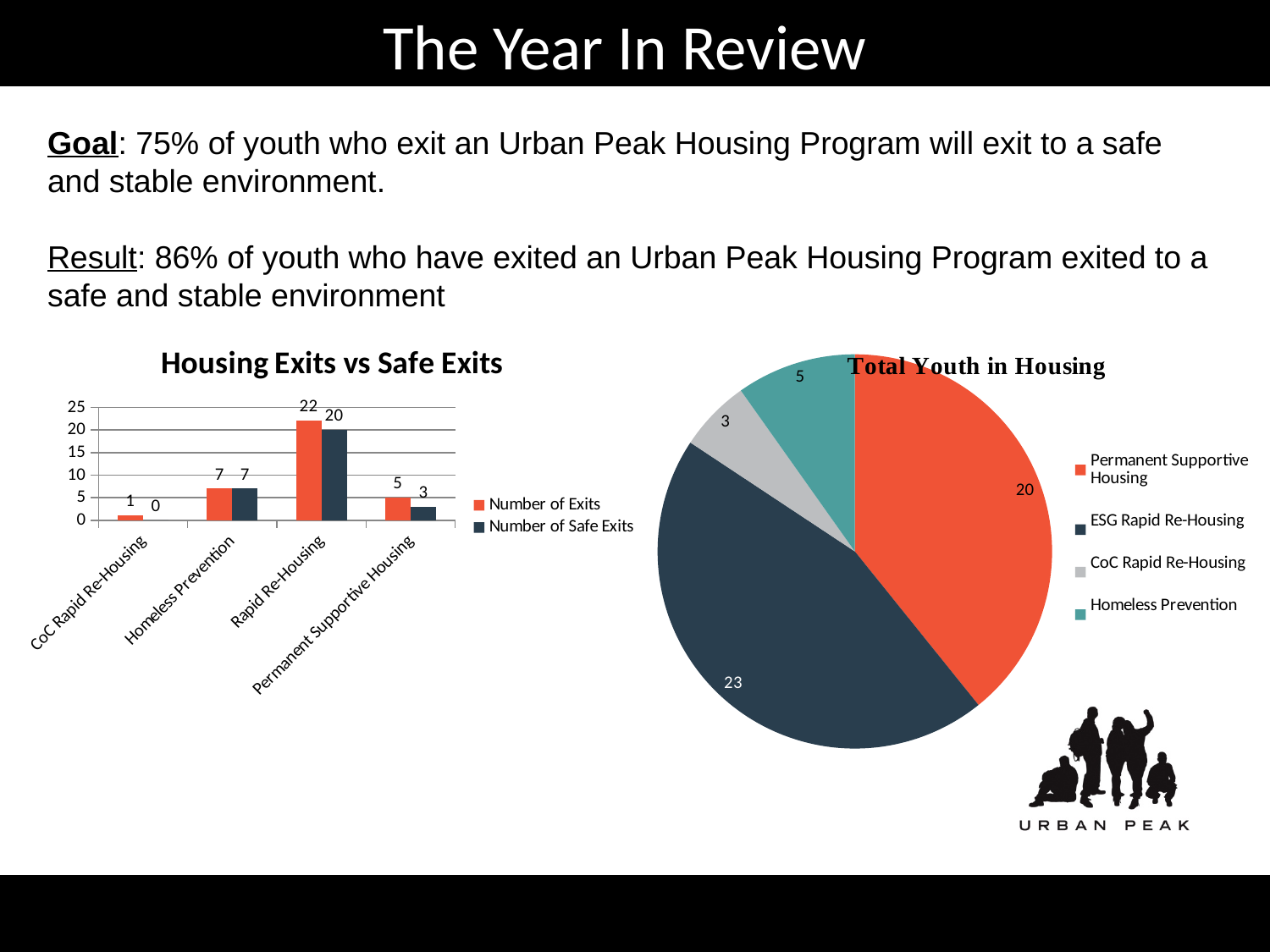
In the 'Total Youth in Housing' pie chart, which program has the smallest slice? CoC Rapid Re-Housing In the 'Total Youth in Housing' pie chart, what is the total of all slices? 51 In the 'Housing Exits vs Safe Exits' chart, how many series does the legend list? 2 In the 'Total Youth in Housing' pie chart, which is larger: Permanent Supportive Housing or Homeless Prevention? Permanent Supportive Housing In the 'Housing Exits vs Safe Exits' chart, what is the difference between the Number of Exits and the Number of Safe Exits for Rapid Re-Housing? 2 In the 'Total Youth in Housing' pie chart, how many youth are in ESG Rapid Re-Housing? 23 In the 'Housing Exits vs Safe Exits' chart, which category has the lowest Number of Safe Exits? CoC Rapid Re-Housing In the 'Housing Exits vs Safe Exits' chart, what is the Number of Exits for Rapid Re-Housing? 22 What kind of chart is 'Housing Exits vs Safe Exits'? Bar chart In the 'Housing Exits vs Safe Exits' chart, what is the Number of Safe Exits for Permanent Supportive Housing? 3 In the 'Housing Exits vs Safe Exits' chart, which category has the highest Number of Exits? Rapid Re-Housing In the 'Housing Exits vs Safe Exits' chart, how many categories are shown on the x axis? 4